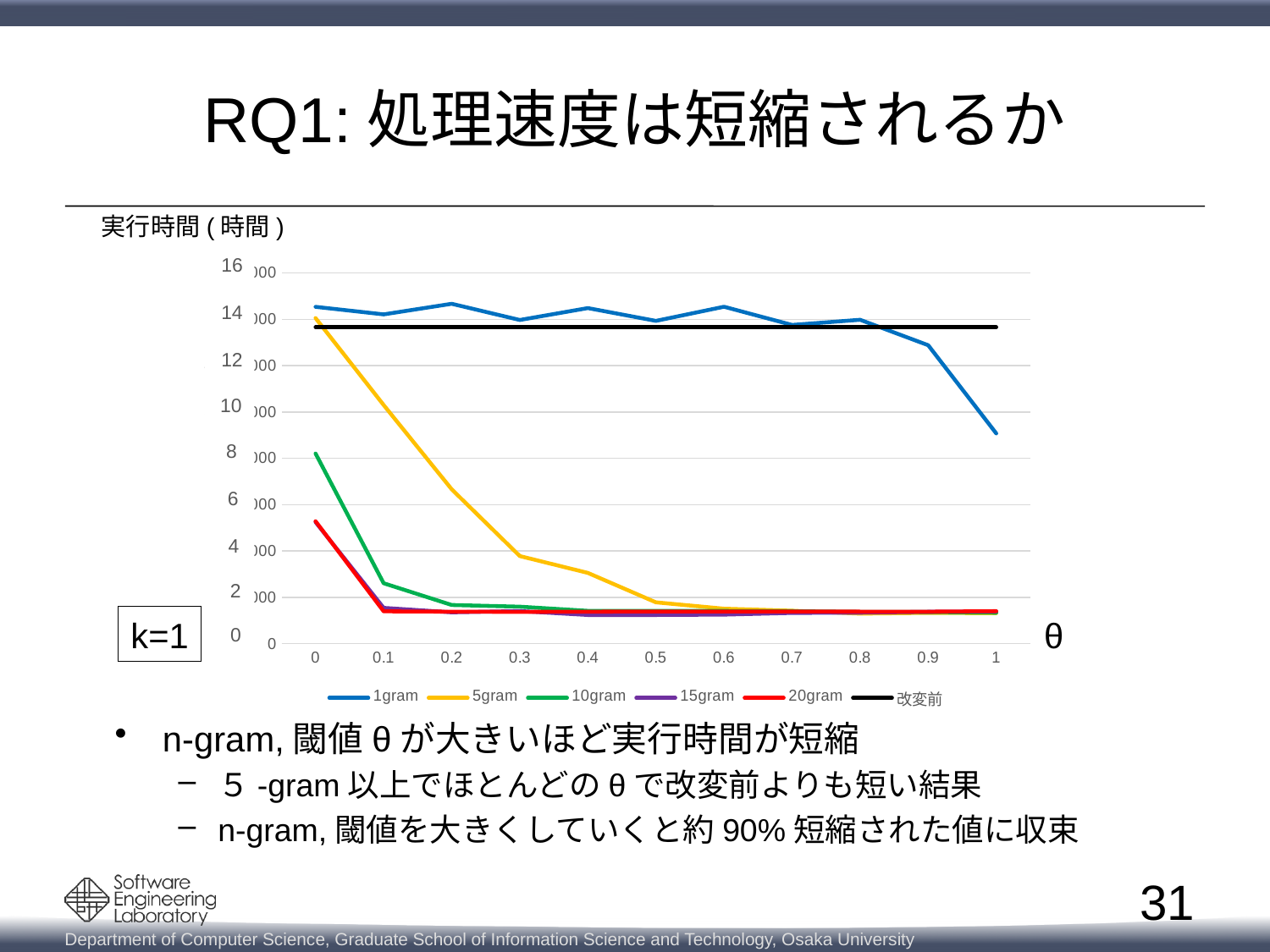
Is the value for 5gram at θ = 0.2 greater or less than 6? greater Is the value for 1gram at θ = 1 greater or less than 10? less At θ = 1, which is larger, the value for 1gram or the value for 5gram? 1gram How many θ values are marked along the x axis of the chart? 11 Is the value for 20gram at θ = 0 greater or less than 4? greater What is the label of the y axis of the chart? 実行時間 ( 時間 ) How many series does the chart legend list? 6 What kind of chart is shown on the slide? line chart Does the 5gram series rise or fall as θ increases from 0 to 1? fall Which series has the highest execution time at θ = 0? 1gram